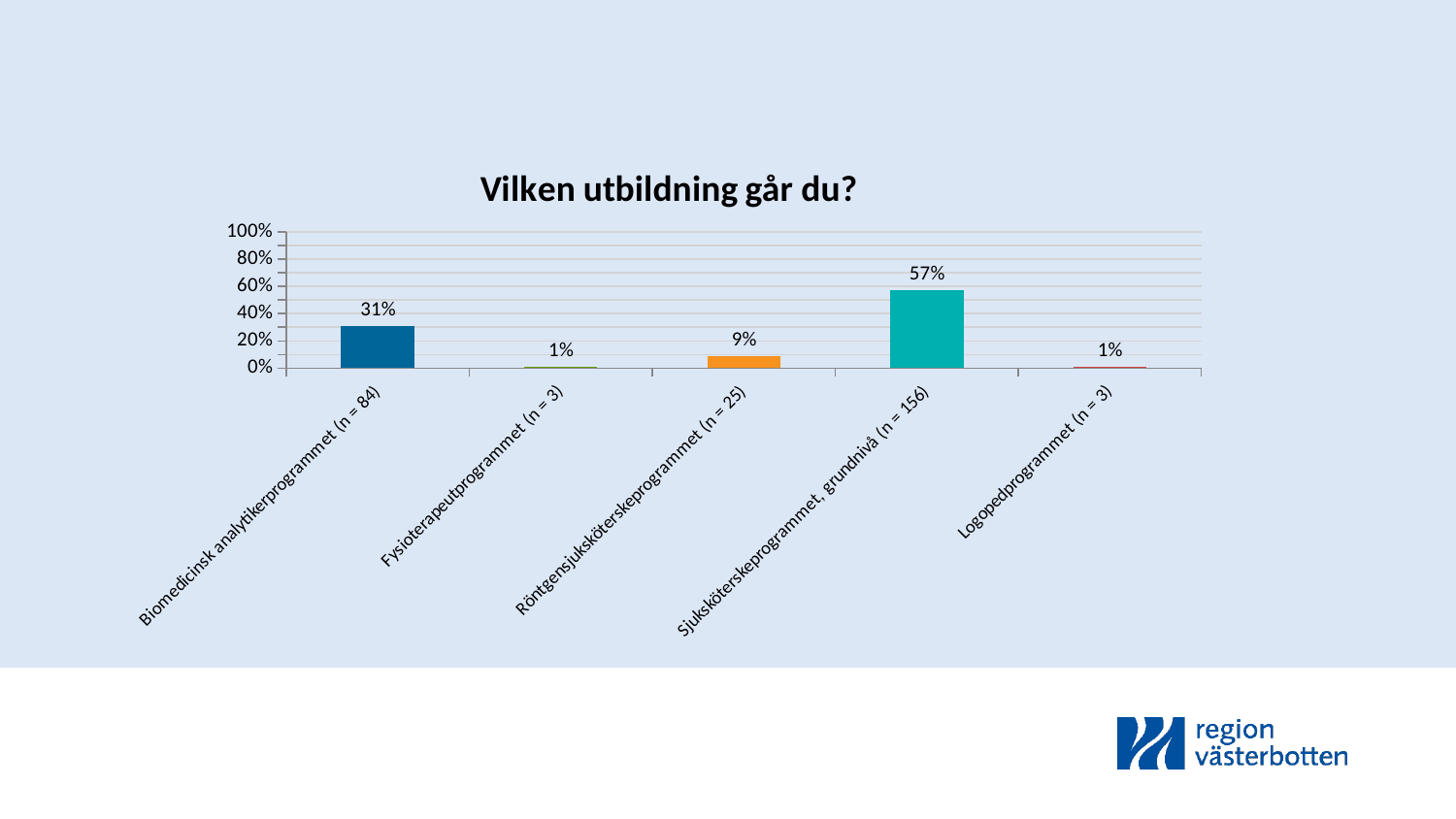
What is the title of the chart? Vilken utbildning går du? What kind of chart is shown on the slide? Bar chart Which category has the highest value? Sjuksköterskeprogrammet, grundnivå (n = 156) What is the value for Sjuksköterskeprogrammet, grundnivå (n = 156)? 57% What is the value for Logopedprogrammet (n = 3)? 1% How many categories are shown on the x axis? 5 What is the highest value shown on the y axis? 100% What is the value for Röntgensjuksköterskeprogrammet (n = 25)? 9% Which is larger, the value for Biomedicinsk analytikerprogrammet (n = 84) or the value for Röntgensjuksköterskeprogrammet (n = 25)? Biomedicinsk analytikerprogrammet (n = 84) What is the value for Biomedicinsk analytikerprogrammet (n = 84)? 31% Is the value for Sjuksköterskeprogrammet, grundnivå (n = 156) greater or less than 40%? greater What is the difference between the values for Sjuksköterskeprogrammet, grundnivå (n = 156) and Biomedicinsk analytikerprogrammet (n = 84)? 26%